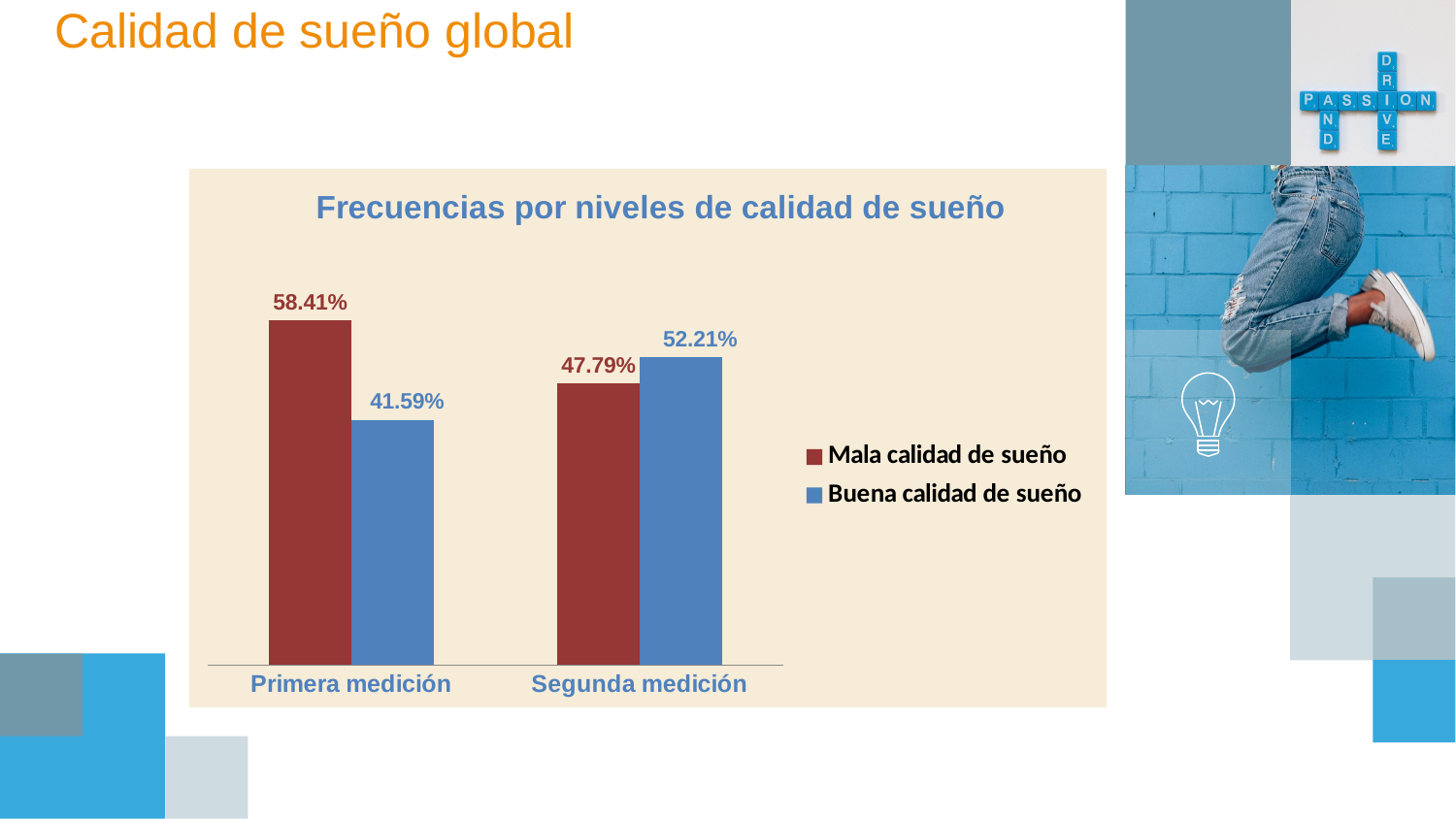
What is the difference between Mala calidad de sueño and Buena calidad de sueño in Primera medición? 16.82% What is the value for Buena calidad de sueño in Primera medición? 41.59% How many categories are shown on the x axis? 2 How many series does the legend list? 2 What is the value for Buena calidad de sueño in Segunda medición? 52.21% Which bar has the highest value in the chart? Mala calidad de sueño, Primera medición What kind of chart is shown on the slide? Bar chart What is the title of the chart? Frecuencias por niveles de calidad de sueño Which bar has the lowest value in the chart? Buena calidad de sueño, Primera medición In Segunda medición, which is larger: Mala calidad de sueño or Buena calidad de sueño? Buena calidad de sueño What is the value for Mala calidad de sueño in Segunda medición? 47.79% What is the value for Mala calidad de sueño in Primera medición? 58.41%